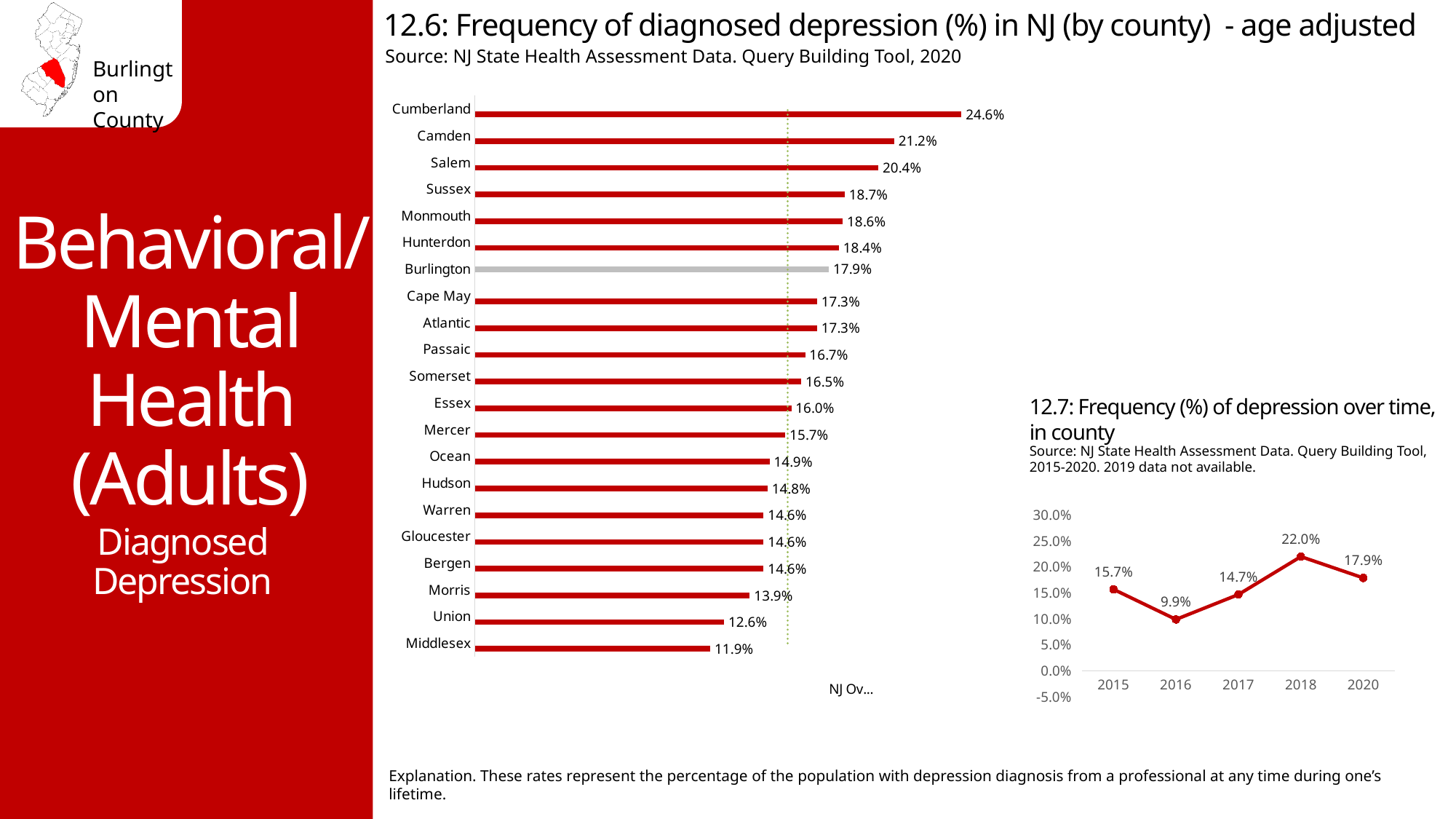
In chart 12.6 (Frequency of diagnosed depression by county), how many counties are plotted? 21 In chart 12.6 (Frequency of diagnosed depression by county), which county has the lowest value? Middlesex In chart 12.7 (Frequency of depression over time, in county), what is the value for 2018? 22.0% In chart 12.7 (Frequency of depression over time, in county), which year has the lowest value? 2016 In chart 12.7 (Frequency of depression over time, in county), how many data points are plotted? 5 In chart 12.6 (Frequency of diagnosed depression by county), which is larger, the value for Camden or the value for Salem? Camden In chart 12.6 (Frequency of diagnosed depression by county), what is the difference between Cumberland and Middlesex? 12.7% In chart 12.7 (Frequency of depression over time, in county), what is the difference between the 2018 and 2020 values? 4.1% In chart 12.6 (Frequency of diagnosed depression by county), what is the value for Union? 12.6% What kind of chart is chart 12.6 (Frequency of diagnosed depression by county)? Bar chart In chart 12.6 (Frequency of diagnosed depression by county), which county has the highest value? Cumberland In chart 12.6 (Frequency of diagnosed depression by county), what is the value for Burlington? 17.9%